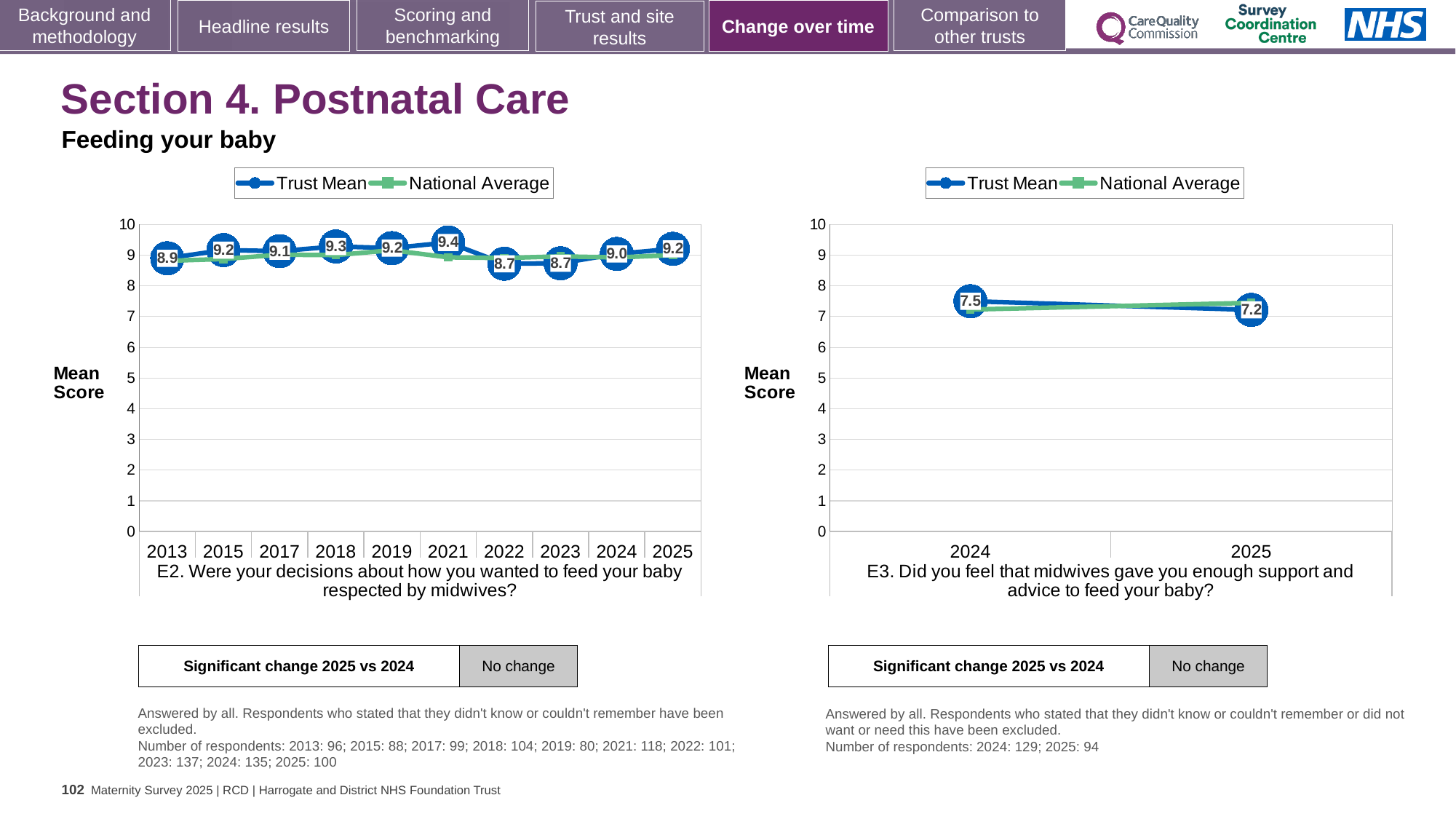
In the E3 chart on the right, what is the difference between the Trust Mean in 2024 and in 2025? 0.3 In the E2 chart on the left, what is the lowest Trust Mean value shown? 8.7 In the E3 chart on the right, does the Trust Mean rise or fall from 2024 to 2025? fall In the E2 chart on the left, which year has the highest Trust Mean? 2021 In the E2 chart on the left, what is the Trust Mean for 2013? 8.9 In the E2 chart on the left, how many years are shown on the x axis? 10 In the E3 chart on the right, is the National Average for 2024 greater or less than 8? less In the E2 chart on the left, what is the difference between the Trust Mean in 2021 and in 2022? 0.7 In the E2 chart on the left, what is the Trust Mean for 2021? 9.4 In the E2 chart on the left, is the Trust Mean higher in 2018 or in 2024? 2018 In the E3 chart on the right, what is the Trust Mean for 2024? 7.5 How many series does the legend of the E3 chart on the right list? 2